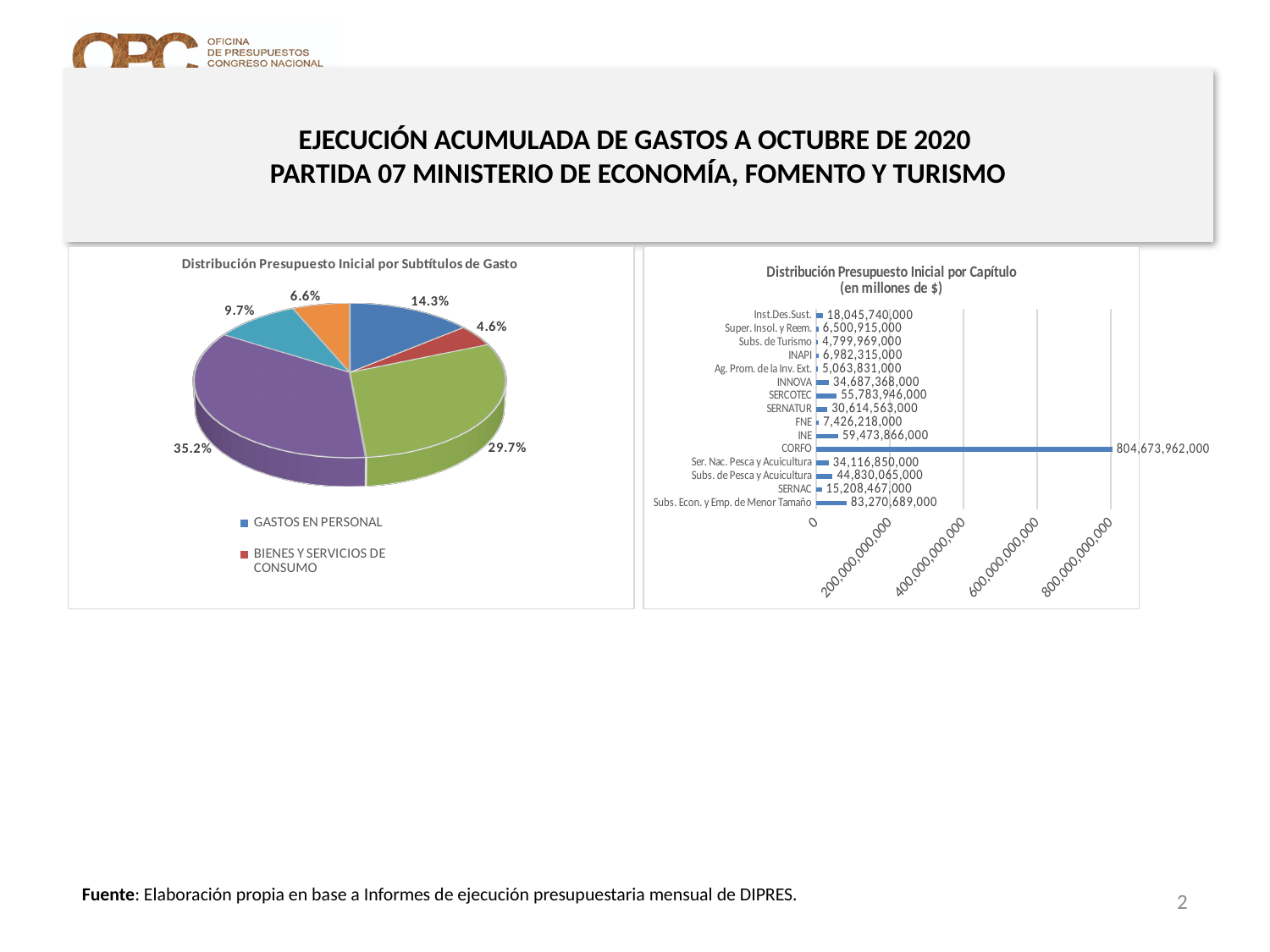
On the pie chart titled 'Distribución Presupuesto Inicial por Subtítulos de Gasto', what share does BIENES Y SERVICIOS DE CONSUMO have? 4.6% On the chart titled 'Distribución Presupuesto Inicial por Capítulo', which category has the highest value? CORFO On the chart titled 'Distribución Presupuesto Inicial por Capítulo', which is larger, the value for INNOVA or the value for SERNATUR? INNOVA On the chart titled 'Distribución Presupuesto Inicial por Capítulo', what is the difference between the values for INE and SERCOTEC? 3,689,920,000 On the pie chart titled 'Distribución Presupuesto Inicial por Subtítulos de Gasto', what share does GASTOS EN PERSONAL have? 14.3% What kind of chart is 'Distribución Presupuesto Inicial por Capítulo'? bar chart On the chart titled 'Distribución Presupuesto Inicial por Capítulo', which category has the lowest value? Subs. de Turismo On the chart titled 'Distribución Presupuesto Inicial por Capítulo', what is the value for CORFO? 804,673,962,000 On the chart titled 'Distribución Presupuesto Inicial por Capítulo', how many categories are shown? 15 On the pie chart titled 'Distribución Presupuesto Inicial por Subtítulos de Gasto', how many slices are there? 6 On the chart titled 'Distribución Presupuesto Inicial por Capítulo', what is the value for SERCOTEC? 55,783,946,000 On the chart titled 'Distribución Presupuesto Inicial por Capítulo', is the value for CORFO greater or less than 800,000,000,000? greater